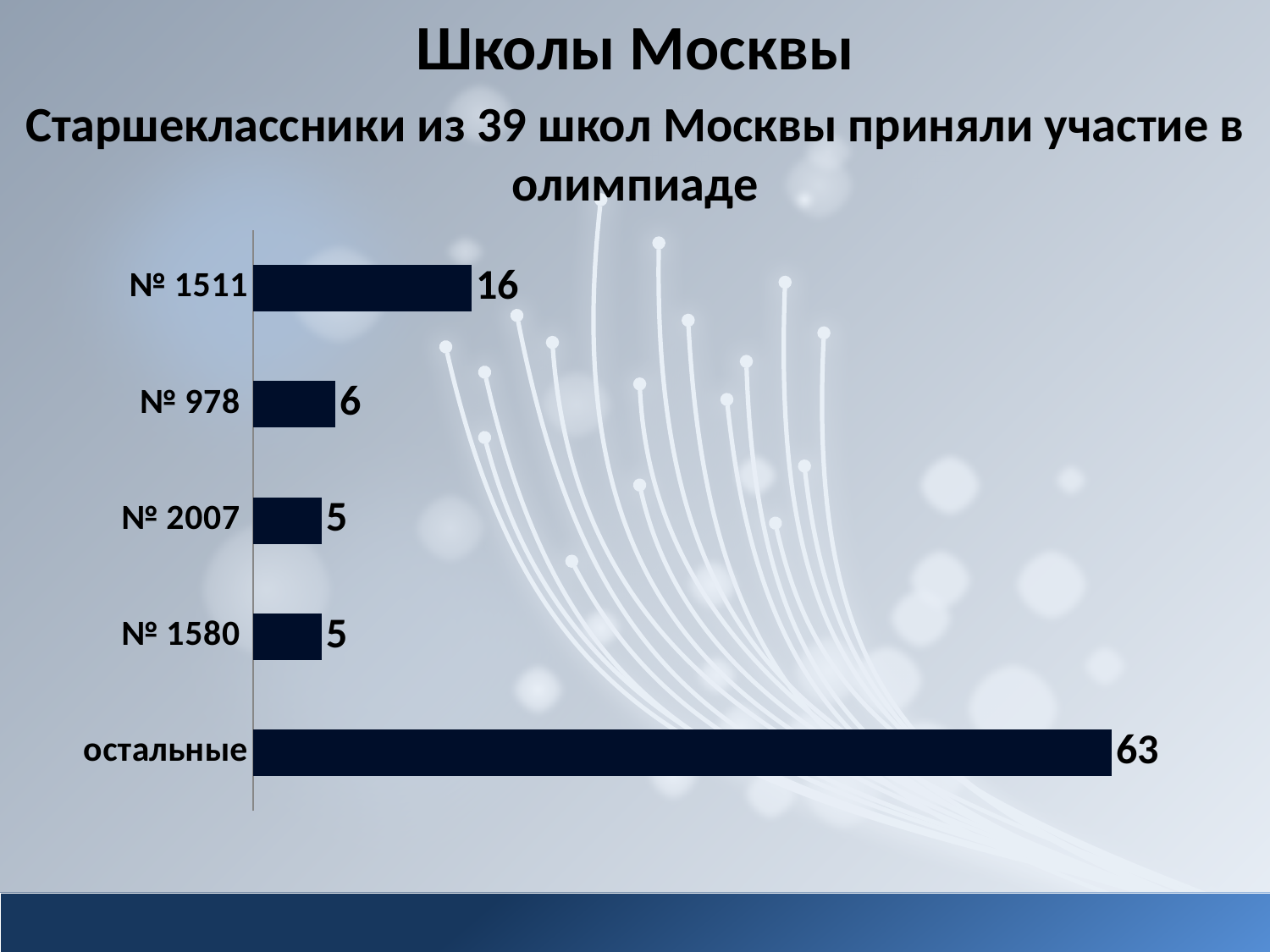
What is the difference between the values for остальные and № 1511? 47 How many categories are shown in the chart? 5 Which category has the highest value? остальные What is the title of the slide? Школы Москвы Which two categories share the same value of 5? № 2007 and № 1580 What is the value for № 2007? 5 What is the difference between the values for № 1511 and № 978? 10 What is the value for остальные? 63 What is the value for № 978? 6 Which is larger, the value for № 1511 or the value for № 978? № 1511 What kind of chart is shown on the slide? bar chart What is the value for № 1511? 16